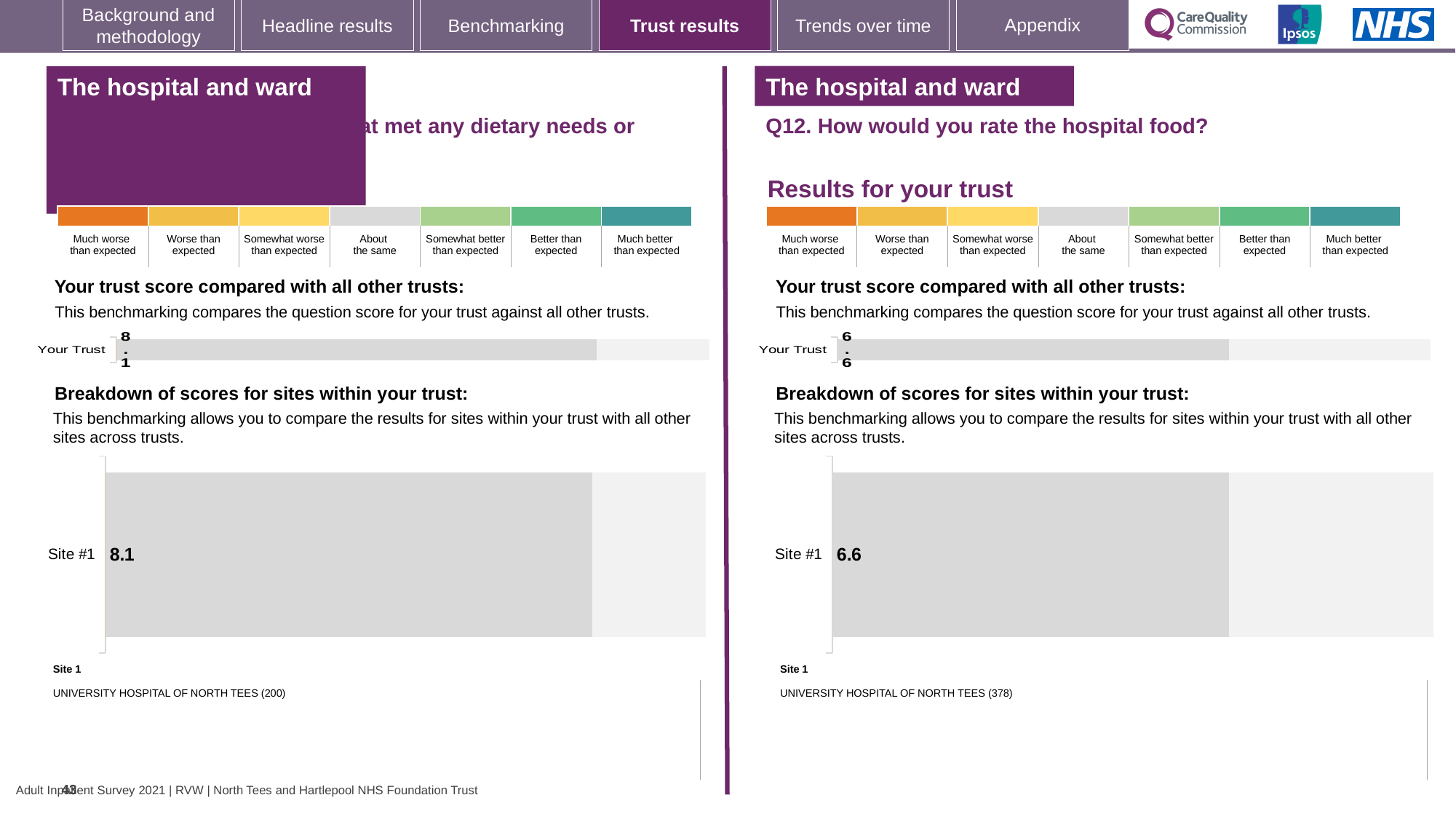
On the right-hand side of the slide (Q12), what score is shown for Site #1 in the breakdown of scores for sites within your trust? 6.6 On the left-hand side of the slide, what is the score shown for Your Trust? 8.1 Which site is listed as Site 1 beneath the breakdown chart on the right-hand side of the slide (Q12)? UNIVERSITY HOSPITAL OF NORTH TEES (378) Which is larger: the Site #1 score on the left-hand side of the slide or the Site #1 score on the right-hand side (Q12)? Left-hand side (8.1) What is the question text shown above the charts on the right-hand side of the slide? Q12. How would you rate the hospital food? On the right-hand side of the slide (Q12, hospital food), what is the score shown for Your Trust? 6.6 What kind of chart is used to show the Site #1 score on the right-hand side of the slide (Q12)? Bar chart On the left-hand side of the slide, what score is shown for Site #1 in the breakdown of scores for sites within your trust? 8.1 What is the difference between the Site #1 score on the left-hand side of the slide (8.1) and the Site #1 score on the right-hand side (6.6)? 1.5 How many sites are shown in the breakdown of scores chart on the left-hand side of the slide? 1 How many sites are shown in the breakdown of scores chart on the right-hand side of the slide (Q12)? 1